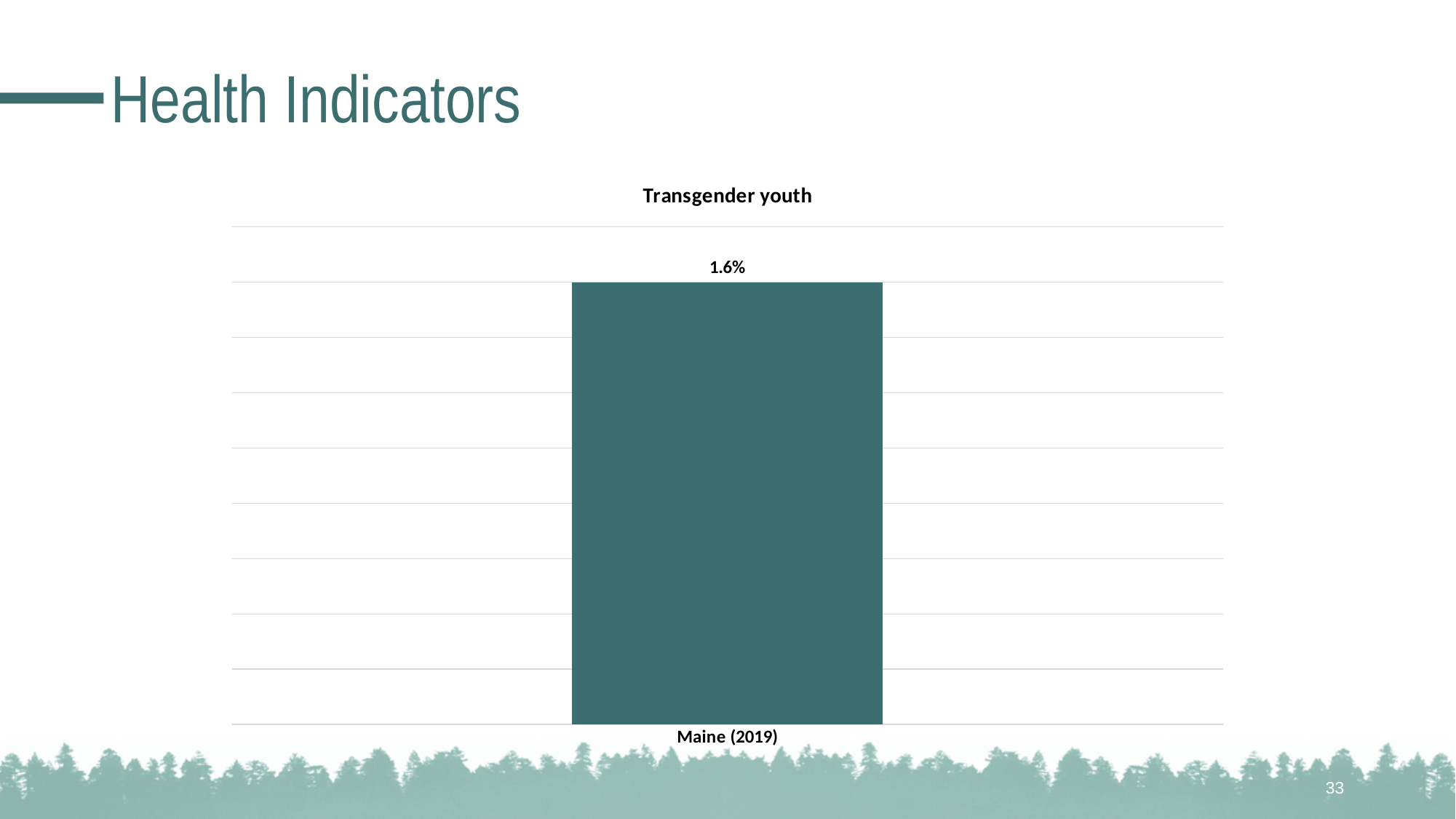
What is the label of the single category on the x axis? Maine (2019) What is the title of the chart on the slide? Transgender youth What is the value for Maine (2019) in the Transgender youth chart? 1.6% Which category has the highest value in the Transgender youth chart? Maine (2019) How many categories are plotted in the Transgender youth chart? 1 What kind of chart is shown on the slide? bar chart